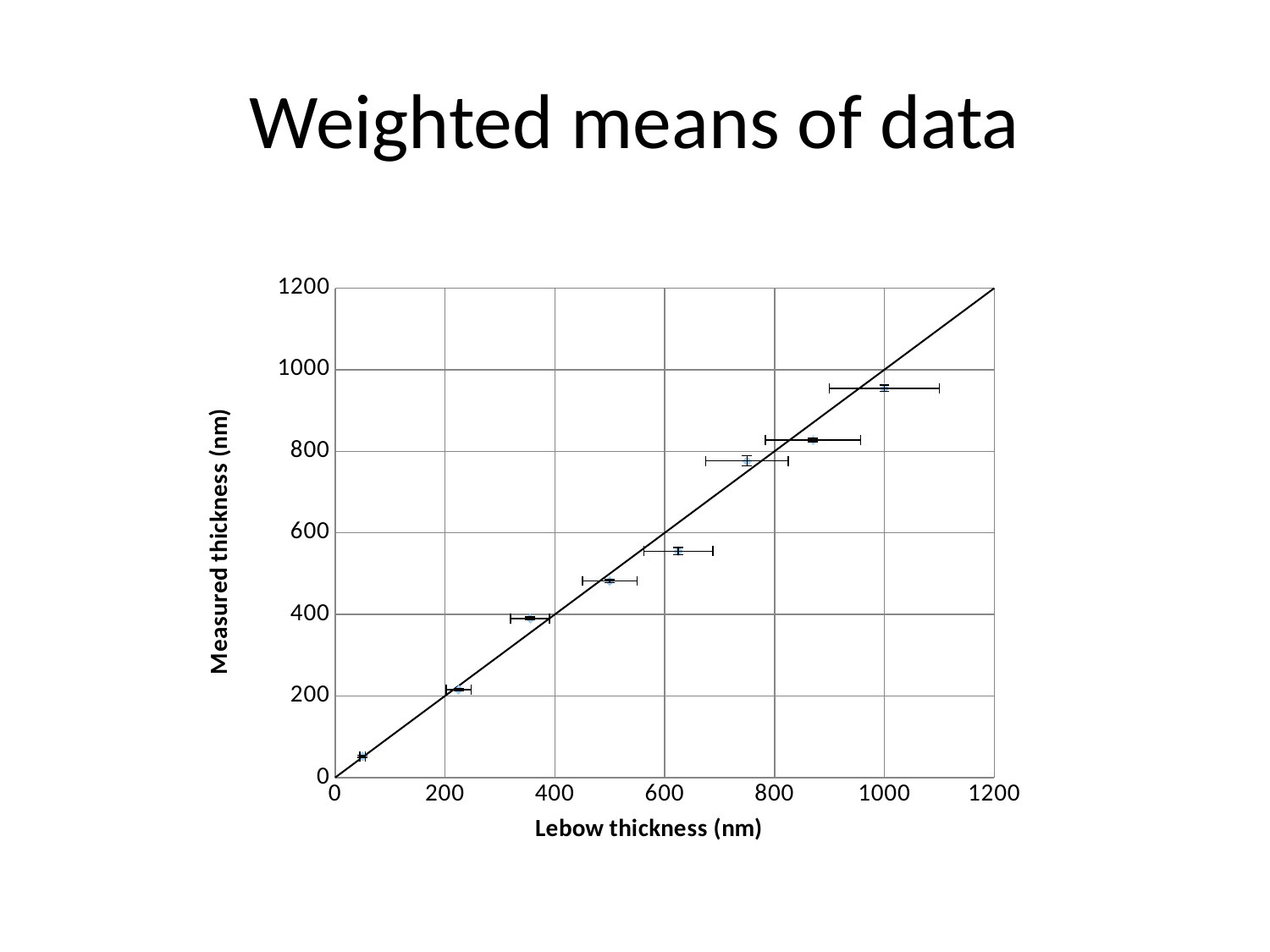
Which data point has the highest measured thickness: the one at a Lebow thickness of about 1000 nm or the one at about 50 nm? the one at about 1000 nm Is the measured thickness for the data point at a Lebow thickness of about 870 nm greater or less than 800? greater What kind of chart is shown on the slide? scatter chart What is the label of the x axis? Lebow thickness (nm) Is the measured thickness for the data point at a Lebow thickness of about 1000 nm greater or less than 1000? less How many data points are plotted on the chart? 8 Is the measured thickness for the data point at a Lebow thickness of about 1000 nm greater or less than 800? greater Do the measured thickness values rise or fall as Lebow thickness increases along the x axis? rise What is the title of the chart? Weighted means of data What is the maximum value shown on the y axis? 1200